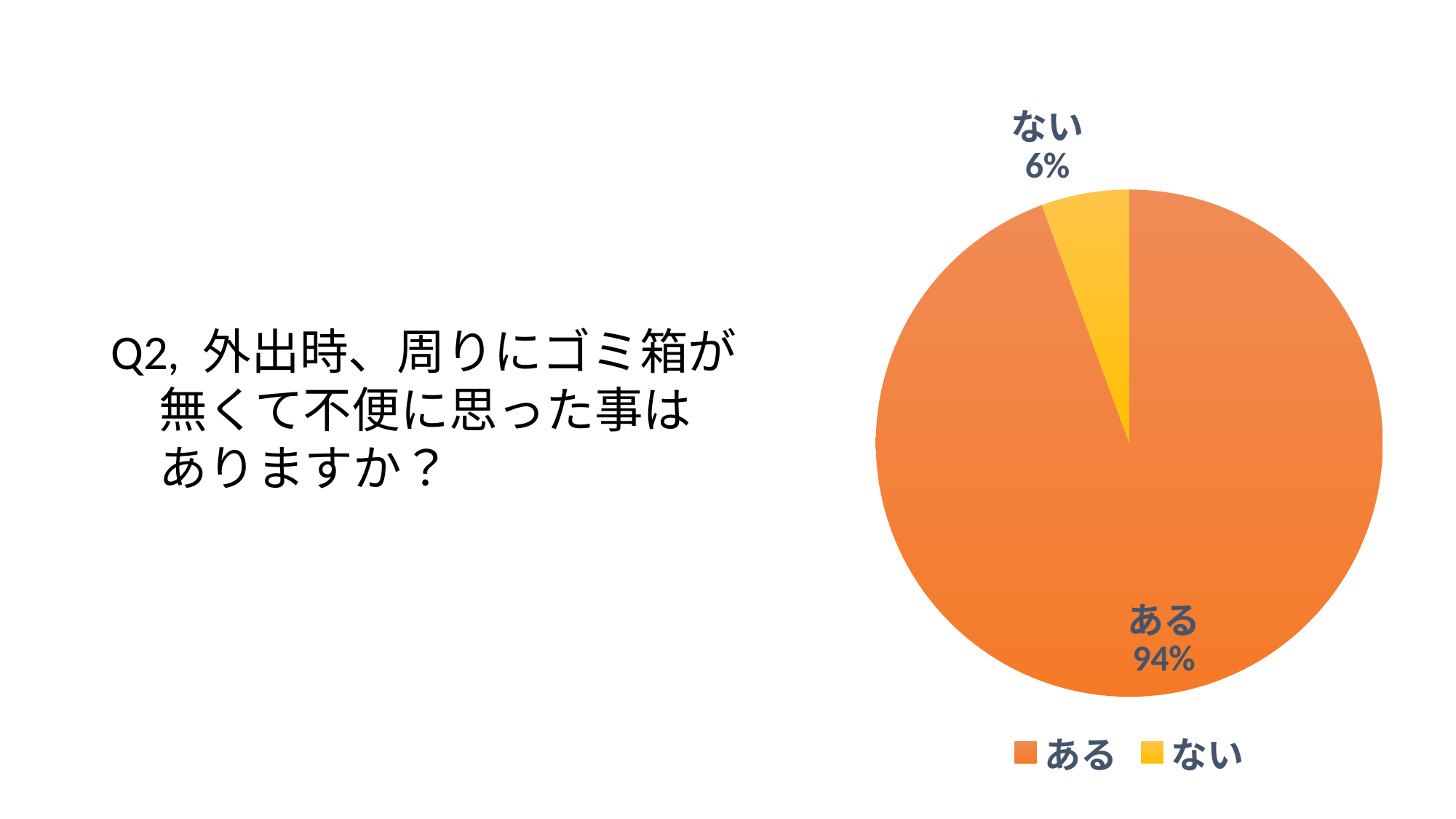
Which category has the smallest slice of the pie? ない What is the difference in percentage points between ある and ない? 88 What kind of chart is shown on the slide? pie chart Is the share for ある greater or less than 50%? greater What colour is the slice for ある? orange What share of the pie does ある represent? 94% What share of the pie does ない represent? 6% Which category has the largest slice of the pie? ある Which is larger, the slice for ある or the slice for ない? ある What colour is the slice for ない? yellow How many categories are shown in the pie chart? 2 How many entries does the legend list? 2